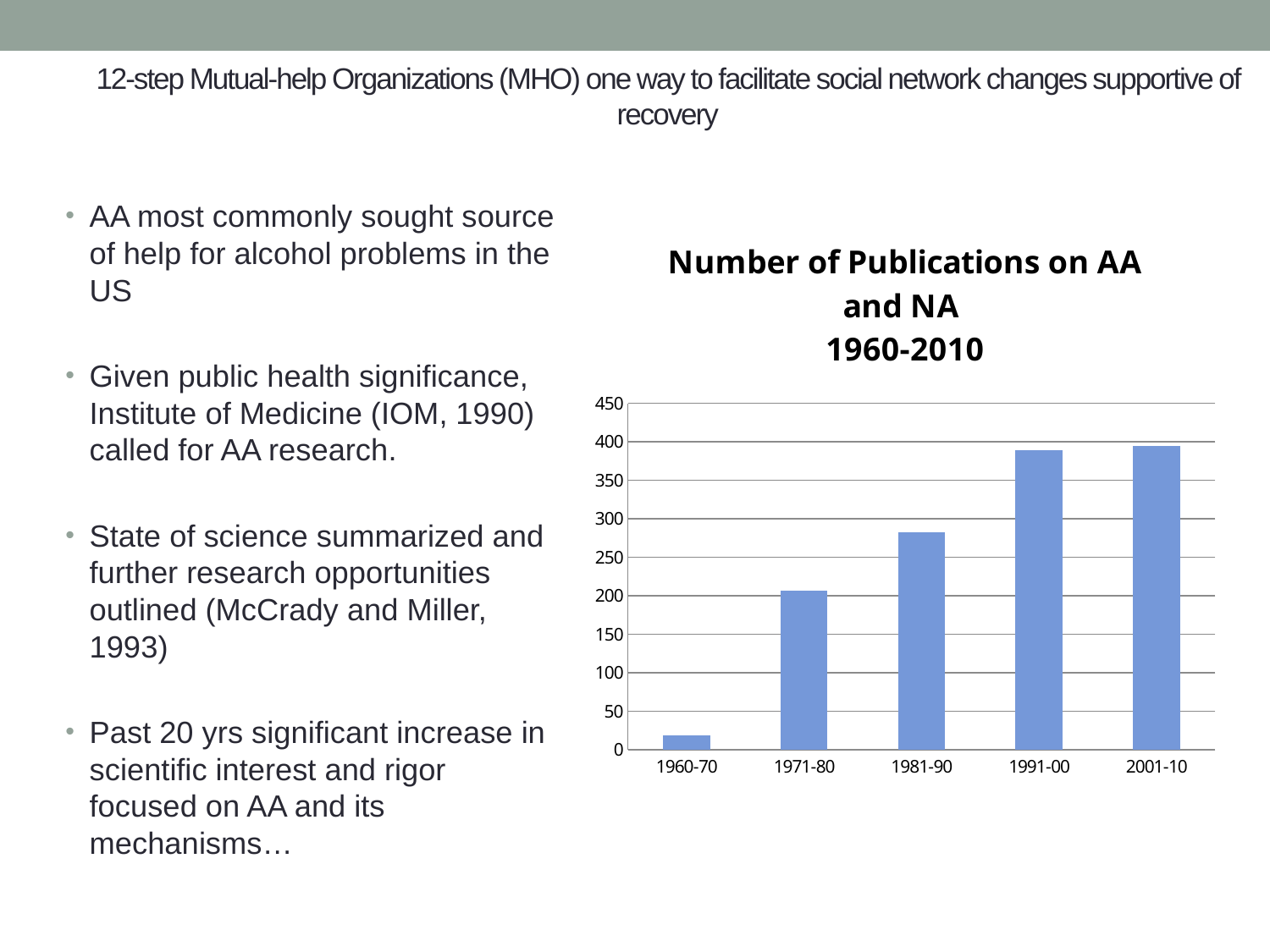
Which has more publications, 1971-80 or 1981-90? 1981-90 Do the number of publications rise or fall across the decades from 1960-70 to 2001-10? rise How many decade categories are shown on the x axis of the chart? 5 What is the highest value shown on the vertical axis of the chart? 450 Is the value for 1981-90 greater or less than 300? less Is the value for 1960-70 greater or less than 50? less Which decade has the lowest number of publications? 1960-70 What is the title of the chart? Number of Publications on AA and NA 1960-2010 Is the value for 1991-00 greater or less than 350? greater What kind of chart is shown on the slide? bar chart